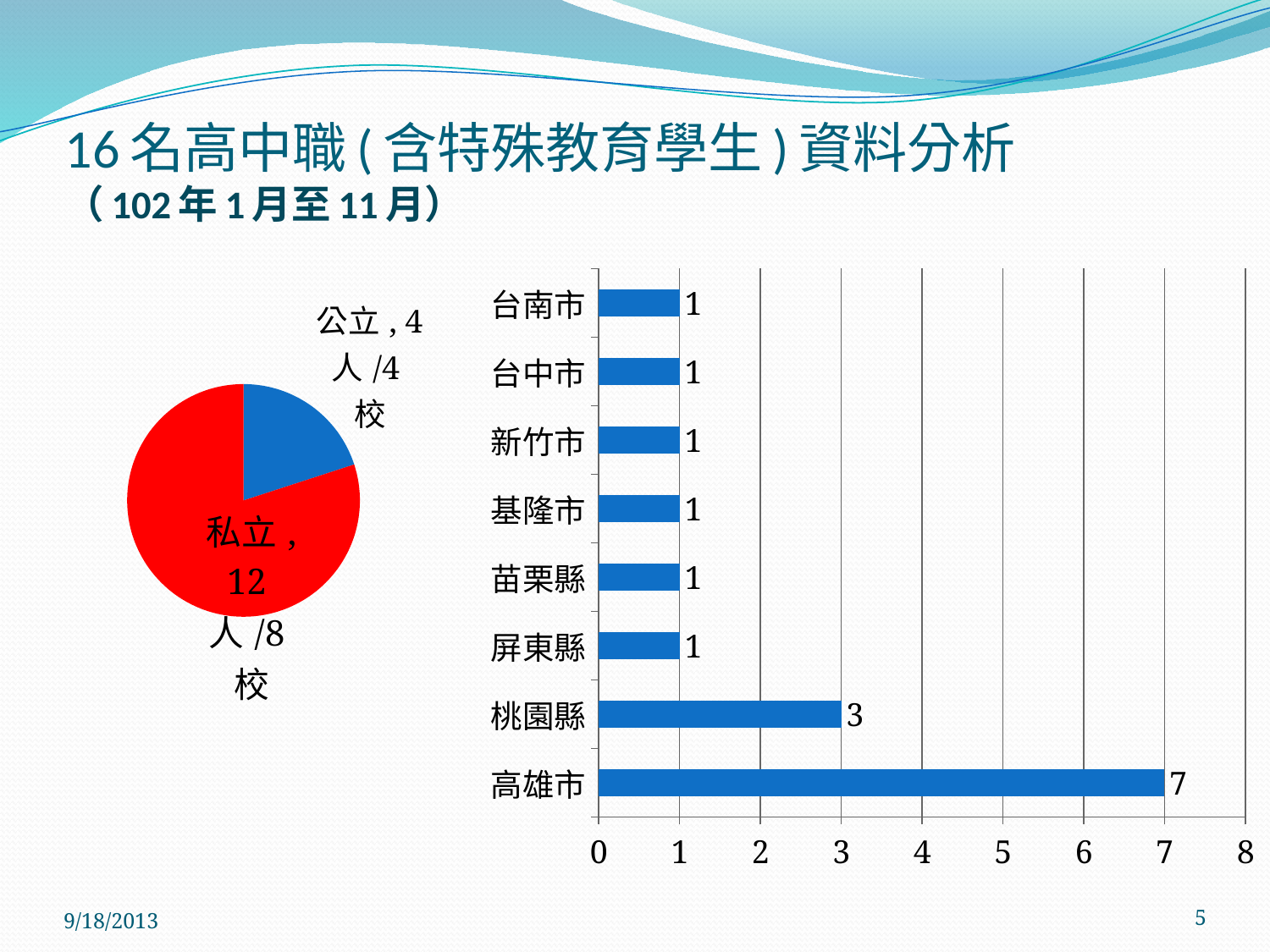
In the bar chart on the right, what is the value for 桃園縣? 3 In the bar chart on the right, what is the difference between the values for 高雄市 and 桃園縣? 4 In the bar chart on the right, which category has the highest value? 高雄市 What kind of chart is the chart on the left of the slide? pie chart In the bar chart on the right, what is the value for 台南市? 1 In the bar chart on the right, how many categories have a value of 1? 6 In the bar chart on the right, how many categories are shown? 8 In the pie chart on the left, how many people are in the 私立 slice? 12 人 In the bar chart on the right, what is the value for 高雄市? 7 What kind of chart is the chart on the right of the slide? bar chart In the bar chart on the right, which is larger, the value for 桃園縣 or the value for 屏東縣? 桃園縣 In the pie chart on the left, what share of the total do the 私立 students (12 of 16) represent? 75%